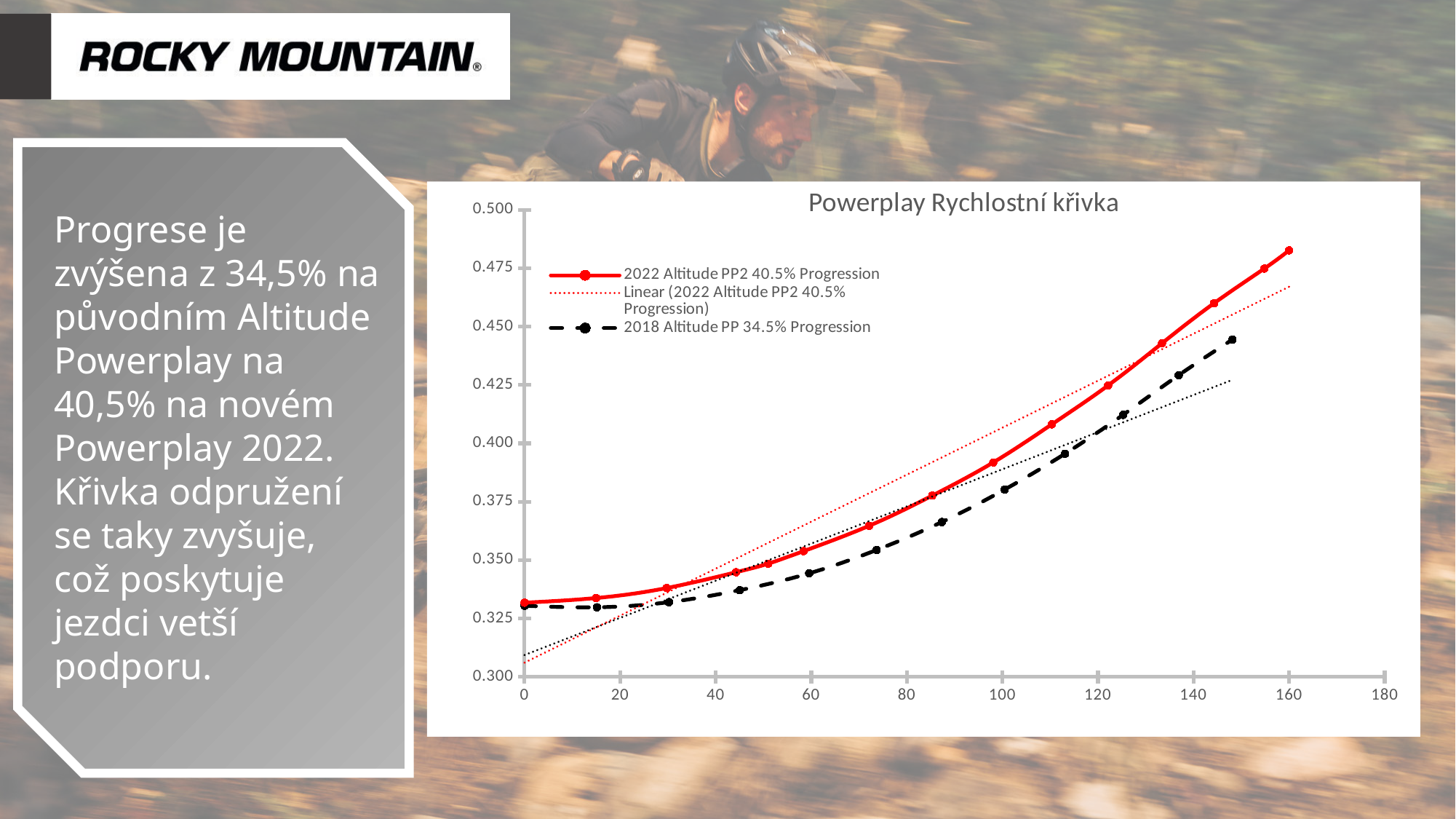
Is the final value of the 2022 Altitude PP2 40.5% Progression series (at x = 160) greater or less than 0.475? greater How many series does the chart legend list? 3 What is the title of the chart? Powerplay Rychlostní křivka Which series reaches the highest value on the chart? 2022 Altitude PP2 40.5% Progression At x = 140, which series has the higher value: 2022 Altitude PP2 40.5% Progression or 2018 Altitude PP 34.5% Progression? 2022 Altitude PP2 40.5% Progression What colour is the line for the 2022 Altitude PP2 40.5% Progression series? red What is the highest value shown on the x axis? 180 Is the value of the 2022 Altitude PP2 40.5% Progression series at x = 0 greater or less than 0.350? less What kind of chart is shown on the slide? line chart Do the values of the 2022 Altitude PP2 40.5% Progression series rise or fall as the x axis increases? rise Is the highest value of the 2018 Altitude PP 34.5% Progression series greater or less than 0.450? less